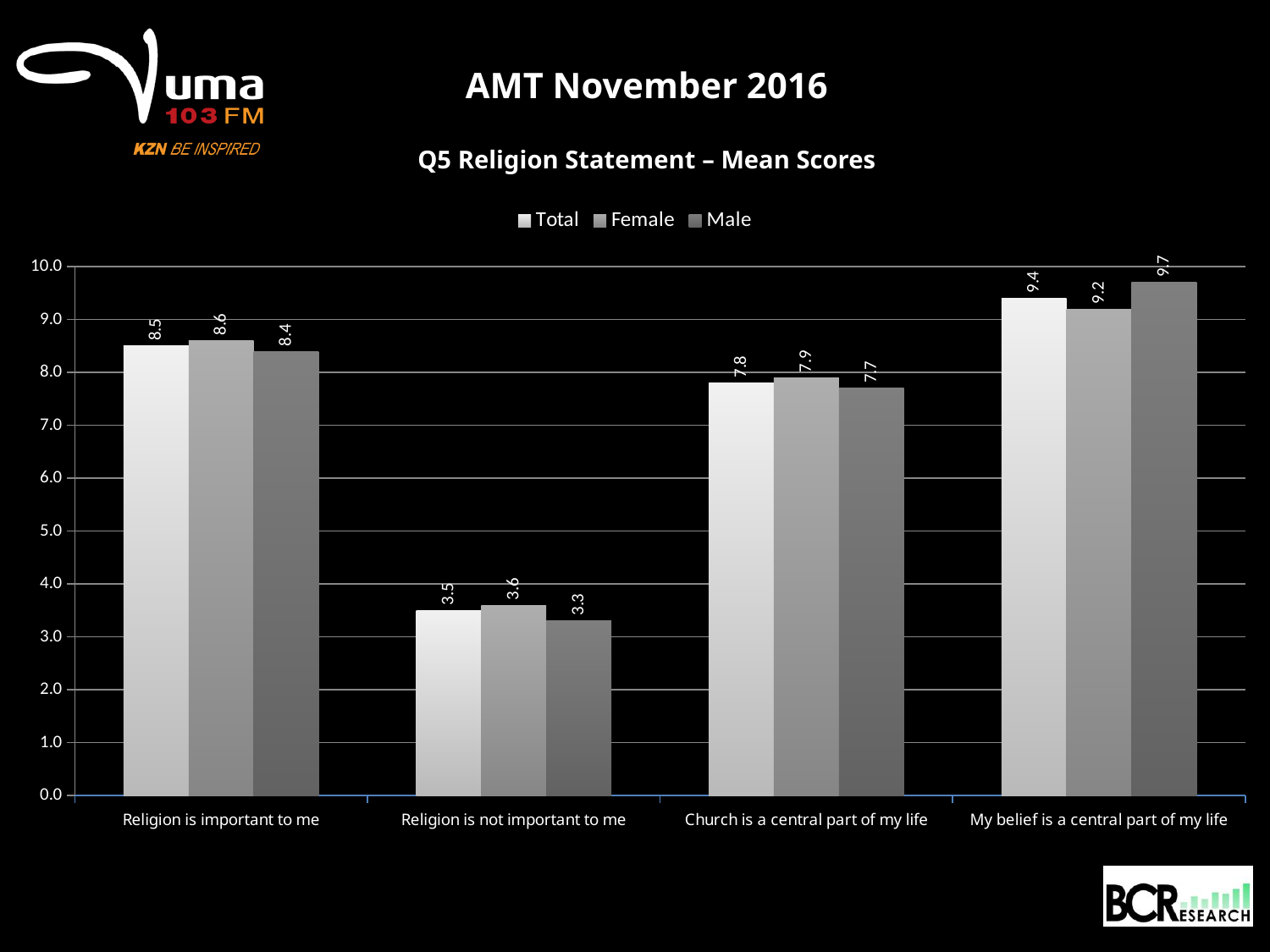
What is the difference between the Male and Female mean scores for "My belief is a central part of my life"? 0.5 What is the Total mean score for "Religion is important to me"? 8.5 Which statement has the highest Total mean score? My belief is a central part of my life What kind of chart is shown on the slide? Bar chart What is the Female mean score for "Church is a central part of my life"? 7.9 What is the Male mean score for "My belief is a central part of my life"? 9.7 Is the Total mean score for "Church is a central part of my life" greater or less than 7.0? greater How many statements (categories) are shown on the x axis? 4 Which is larger for "Religion is important to me": the Female score or the Male score? Female What is the Male mean score for "Religion is not important to me"? 3.3 How many series does the legend list? 3 Which statement has the lowest Total mean score? Religion is not important to me